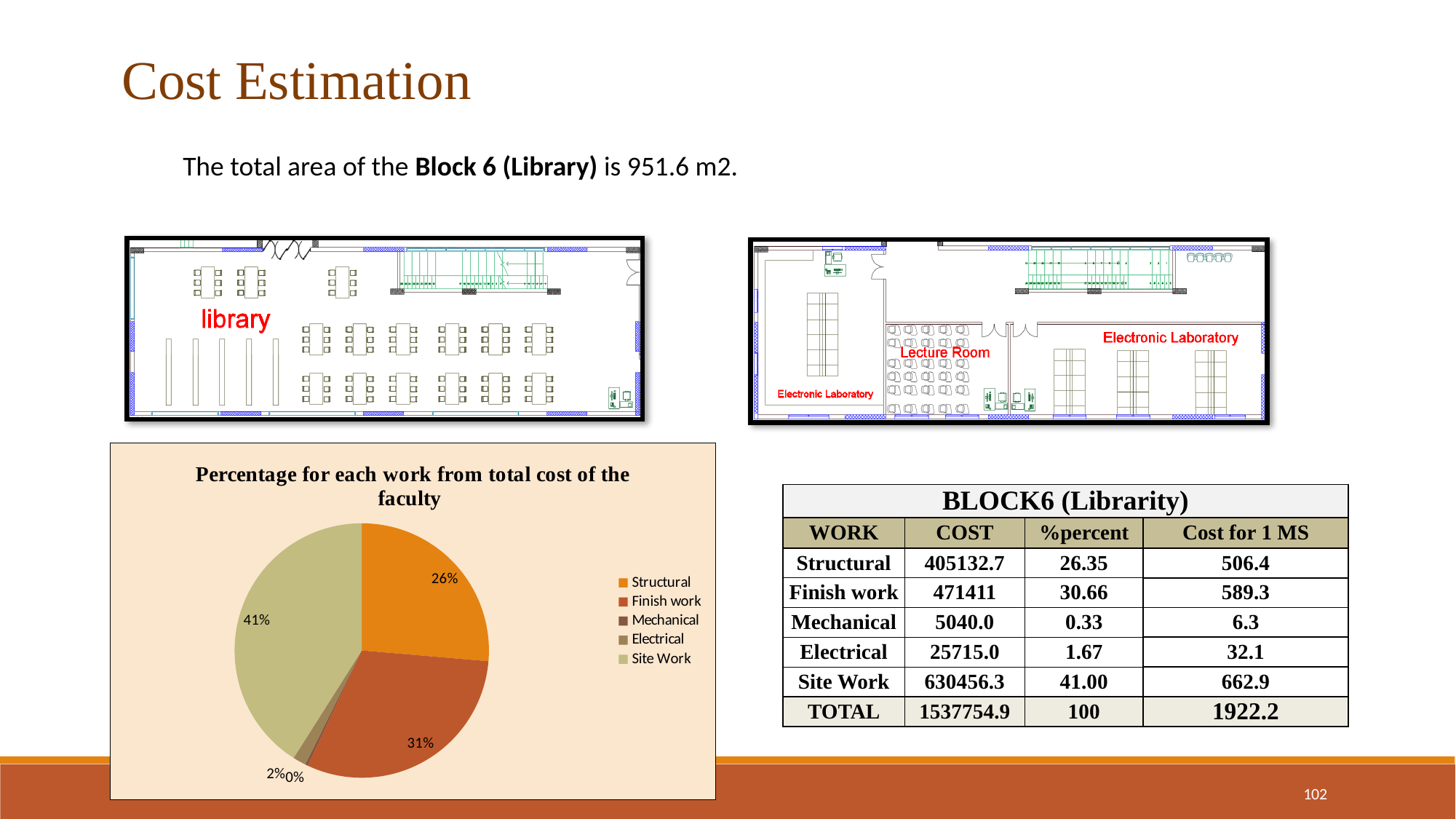
What percentage does the Site Work slice show in the pie chart? 41% What percentage does the Finish work slice show in the pie chart? 31% What percentage does the Mechanical slice show in the pie chart? 0% What type of chart is shown on the slide? pie chart Which work category has the smallest share of the pie chart? Mechanical What is the title of the pie chart? Percentage for each work from total cost of the faculty What percentage does the Structural slice show in the pie chart? 26% Which has a larger share in the pie chart, Finish work or Structural? Finish work How many percentage points larger is the Site Work share than the Structural share in the pie chart? 15 How many categories does the legend of the pie chart list? 5 Which work category has the largest share of the pie chart? Site Work What percentage does the Electrical slice show in the pie chart? 2%